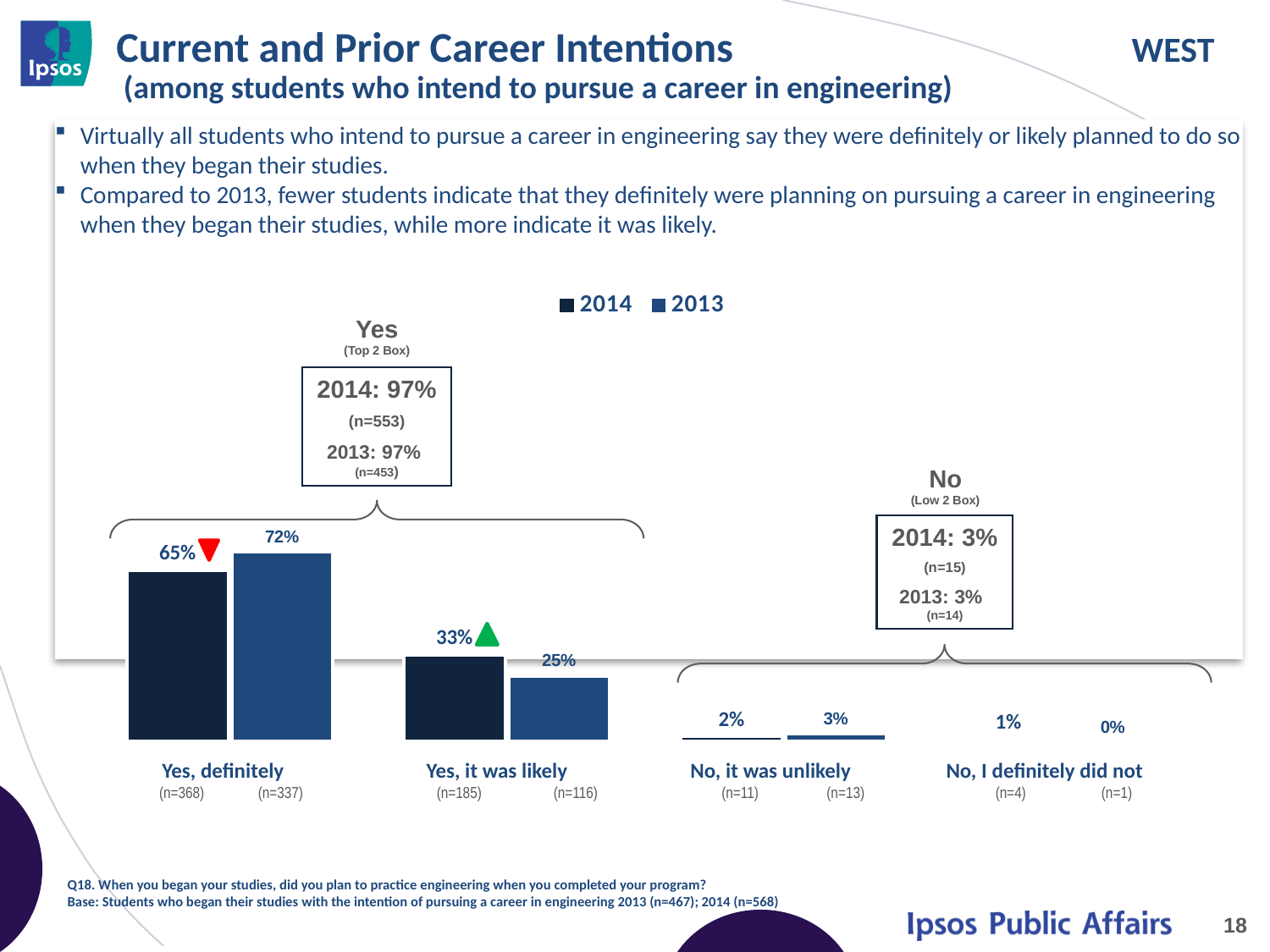
Which category has the highest 2013 value? Yes, definitely What is the difference between the 2013 and 2014 values for "Yes, definitely"? 7% Which is larger for "Yes, it was likely": the 2014 value or the 2013 value? 2014 What is the 2013 value for "Yes, it was likely"? 25% What is the 2014 value for "Yes, definitely"? 65% How many series does the legend list? 2 What is the difference between the 2014 and 2013 values for "Yes, it was likely"? 8% What is the 2013 value for "No, it was unlikely"? 3% How many categories are shown on the x axis? 4 Which category has the lowest 2013 value? No, I definitely did not What kind of chart is shown on the slide? Bar chart What is the 2014 value for "No, I definitely did not"? 1%